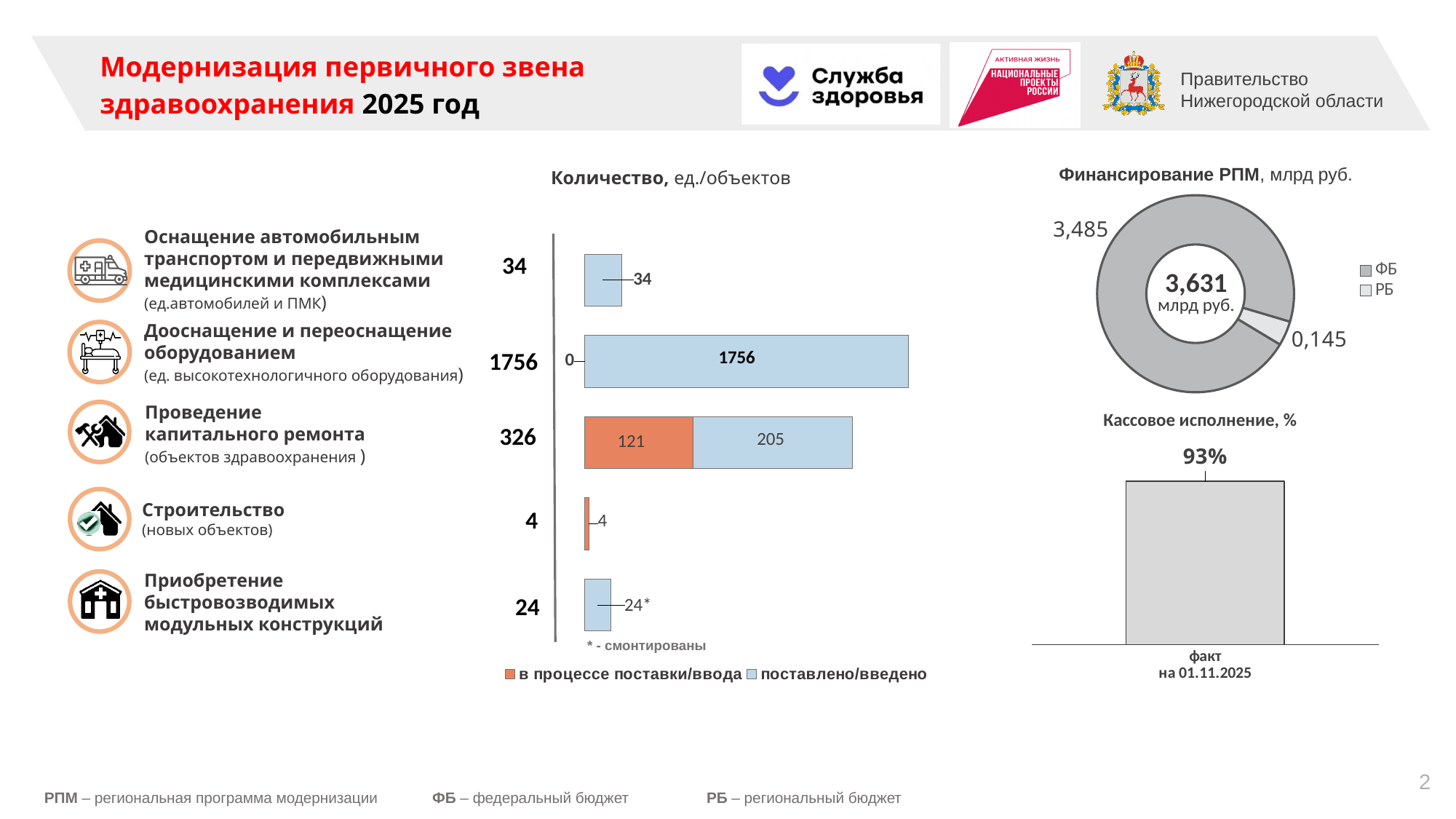
In the chart 'Количество, ед./объектов', how many series does the legend list? 2 In the chart 'Кассовое исполнение, %', what is the value for 'факт на 01.11.2025'? 93% In the chart 'Количество, ед./объектов', what is the total for 'Проведение капитального ремонта'? 326 In the chart 'Количество, ед./объектов', which category has the highest total value? Дооснащение и переоснащение оборудованием In the chart 'Количество, ед./объектов', how many units are shown as 'поставлено/введено' for 'Дооснащение и переоснащение оборудованием'? 1756 In the chart 'Финансирование РПМ, млрд руб.', what total is shown in the centre of the doughnut? 3,631 млрд руб. In the chart 'Финансирование РПМ, млрд руб.', what is the value for ФБ? 3,485 In the chart 'Количество, ед./объектов', how many objects are 'поставлено/введено' for 'Проведение капитального ремонта'? 205 In the chart 'Количество, ед./объектов', how many categories are plotted? 5 In the chart 'Количество, ед./объектов', how many objects are 'в процессе поставки/ввода' for 'Проведение капитального ремонта'? 121 In the chart 'Финансирование РПМ, млрд руб.', what is the value for РБ? 0,145 In the chart 'Количество, ед./объектов', which category has the lowest total value? Строительство